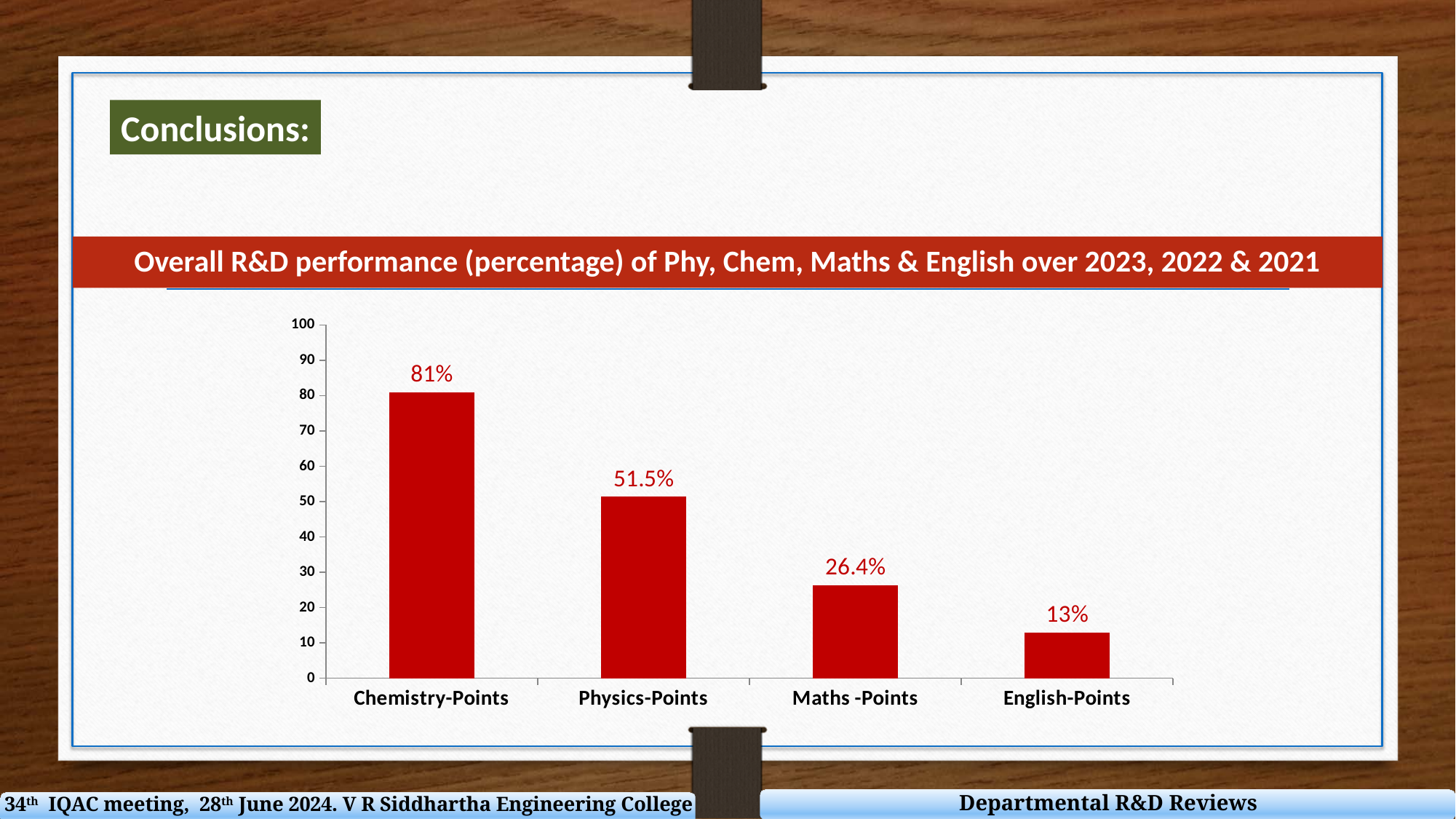
How many categories are shown on the chart? 4 What is the value for Chemistry-Points? 81% Do the values rise or fall from left to right along the x axis? Fall Which category has the lowest value? English-Points What is the value for Maths -Points? 26.4% Which category has the highest value? Chemistry-Points What is the difference between the values for Chemistry-Points and Physics-Points? 29.5% What is the value for English-Points? 13% What kind of chart is shown on the slide? Bar chart What is the difference between the values for Maths -Points and English-Points? 13.4% Which is larger, the value for Physics-Points or the value for Maths -Points? Physics-Points What is the value for Physics-Points? 51.5%